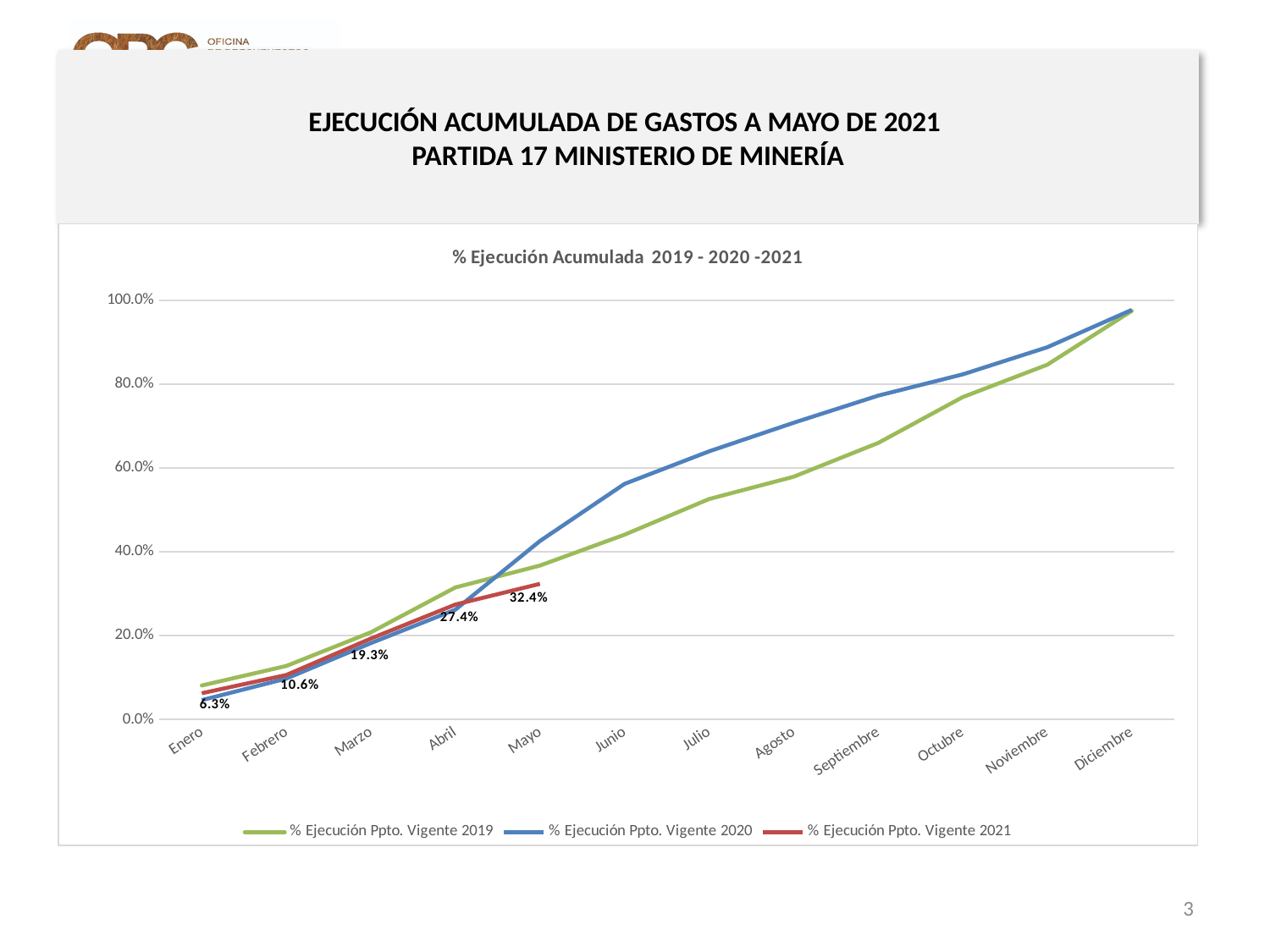
In which month does the % Ejecución Ppto. Vigente 2021 series reach its highest value? Mayo Is the value for % Ejecución Ppto. Vigente 2020 in Junio greater or less than 40.0%? greater How many months are shown on the x axis? 12 How many series does the legend list? 3 What is the difference between the 2021 values for Mayo and Enero? 26.1% What is the value for % Ejecución Ppto. Vigente 2021 in Enero? 6.3% Is the value for % Ejecución Ppto. Vigente 2019 in Octubre greater or less than 80.0%? less In Junio, which series has the larger value: % Ejecución Ppto. Vigente 2019 or % Ejecución Ppto. Vigente 2020? % Ejecución Ppto. Vigente 2020 What is the value for % Ejecución Ppto. Vigente 2021 in Marzo? 19.3% What is the difference between the 2021 values for Abril and Marzo? 8.1% What kind of chart is shown on the slide? Line chart What is the value for % Ejecución Ppto. Vigente 2021 in Mayo? 32.4%